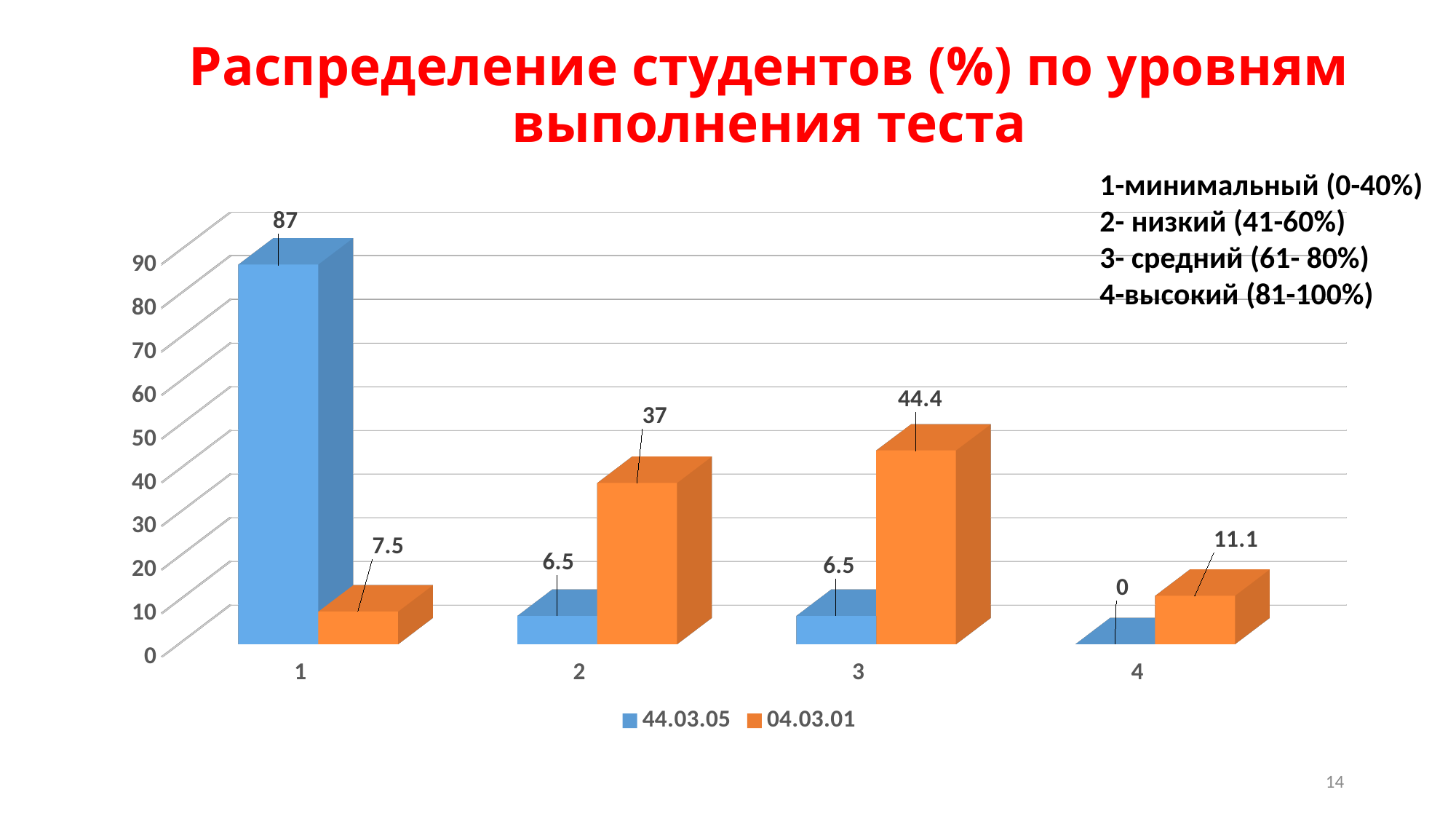
What is the value for series 04.03.01 at category 3? 44.4 What is the difference between the 44.03.05 and 04.03.01 values at category 1? 79.5 How many categories are shown on the x axis? 4 How many series does the legend list? 2 What kind of chart is shown on the slide? Bar chart What is the value for series 04.03.01 at category 4? 11.1 What is the value for series 44.03.05 at category 1? 87 What is the value for series 44.03.05 at category 4? 0 Which series has the larger value at category 2? 04.03.01 Which category has the highest value for series 04.03.01? 3 What colour are the bars for series 04.03.01? Orange Which category has the lowest value for series 44.03.05? 4